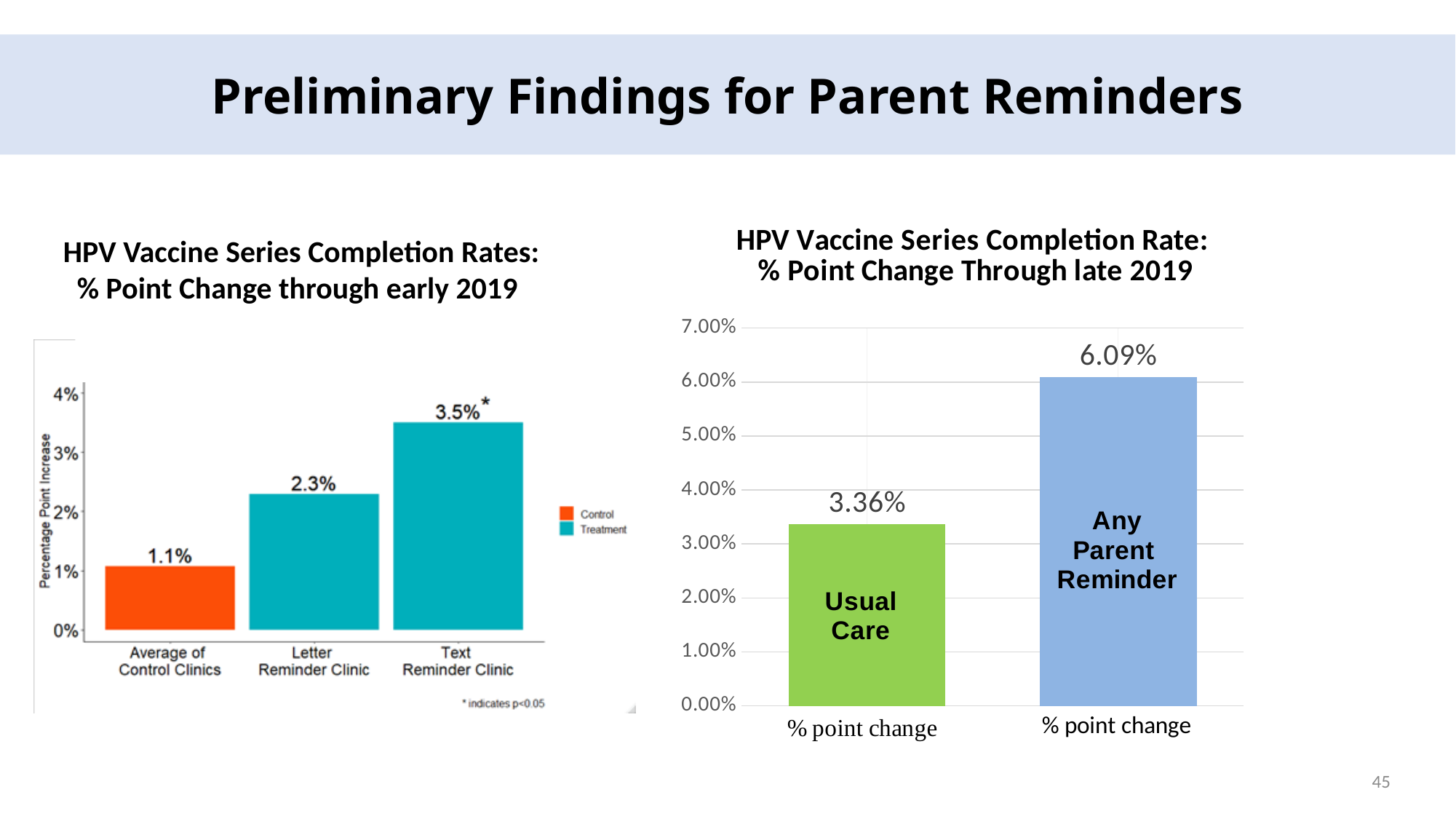
In the left chart (% Point Change through early 2019), which category has the highest value? Text Reminder Clinic In the left chart (% Point Change through early 2019), what is the difference between the Text Reminder Clinic and the Average of Control Clinics? 2.4% In the right chart (% Point Change Through late 2019), which is larger, Usual Care or Any Parent Reminder? Any Parent Reminder In the left chart (% Point Change through early 2019), what is the value for the Text Reminder Clinic? 3.5% What kind of chart is the right chart (% Point Change Through late 2019)? Bar chart In the right chart (% Point Change Through late 2019), what is the value for Any Parent Reminder? 6.09% In the left chart (% Point Change through early 2019), how many series does the legend list? 2 In the right chart (% Point Change Through late 2019), what is the value for Usual Care? 3.36% In the right chart (% Point Change Through late 2019), what is the difference between Any Parent Reminder and Usual Care? 2.73% In the left chart (% Point Change through early 2019), what is the value for the Letter Reminder Clinic? 2.3% In the left chart (% Point Change through early 2019), what is the value for the Average of Control Clinics? 1.1% In the left chart (% Point Change through early 2019), which category has the lowest value? Average of Control Clinics